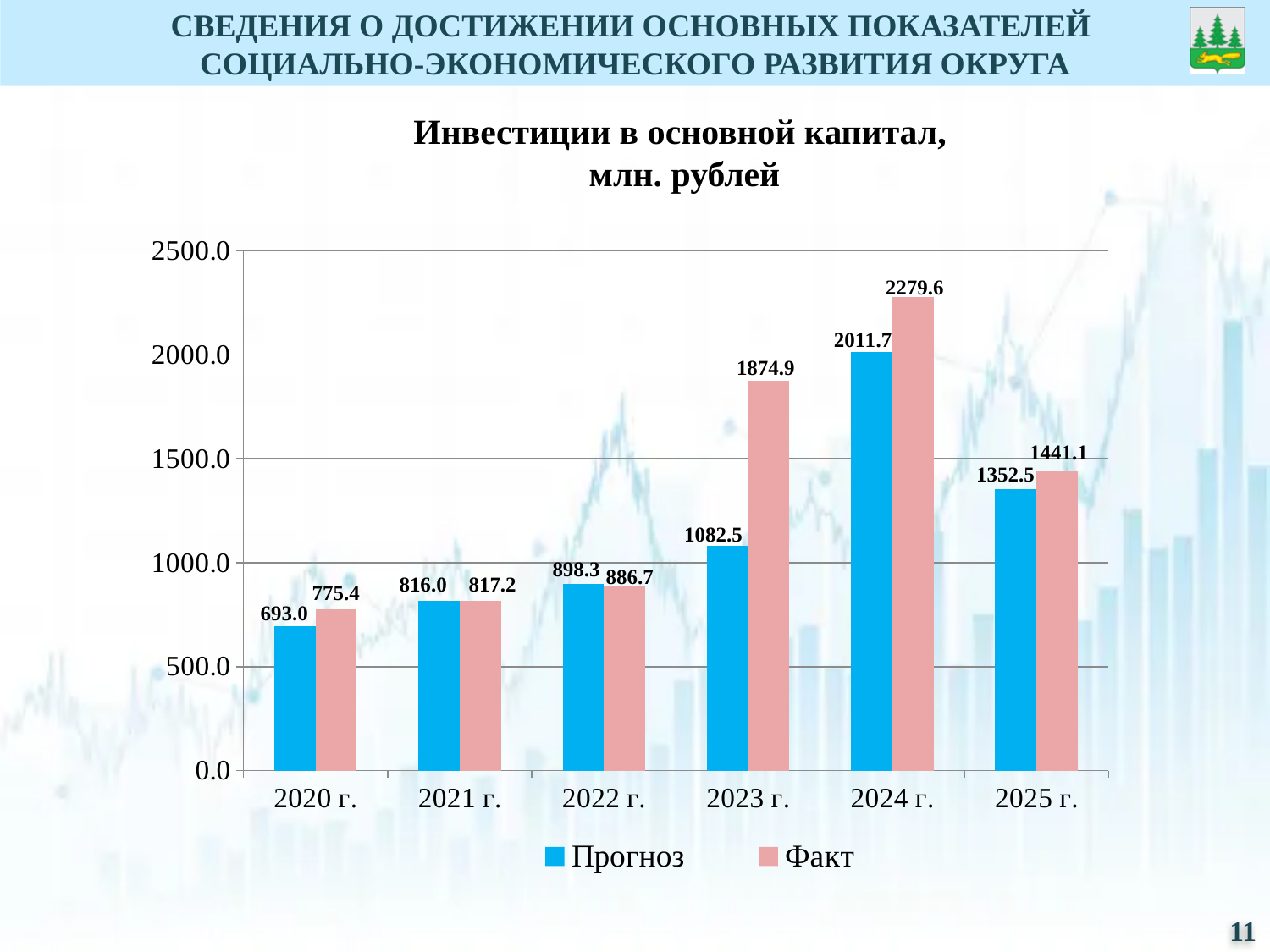
Which year has the lowest Прогноз value? 2020 г. Does the Факт value rise or fall from 2020 г. to 2024 г.? Rise How many years are shown on the x axis? 6 How many series does the legend list? 2 What is the difference between the Факт and Прогноз values for 2023 г.? 792.4 What is the Факт value for 2024 г.? 2279.6 Which year has the highest Факт value? 2024 г. What is the Прогноз value for 2023 г.? 1082.5 What kind of chart is shown on the slide? Bar chart For 2023 г., which is larger: Прогноз or Факт? Факт What is the Факт value for 2020 г.? 775.4 What is the difference between the Факт and Прогноз values for 2024 г.? 267.9